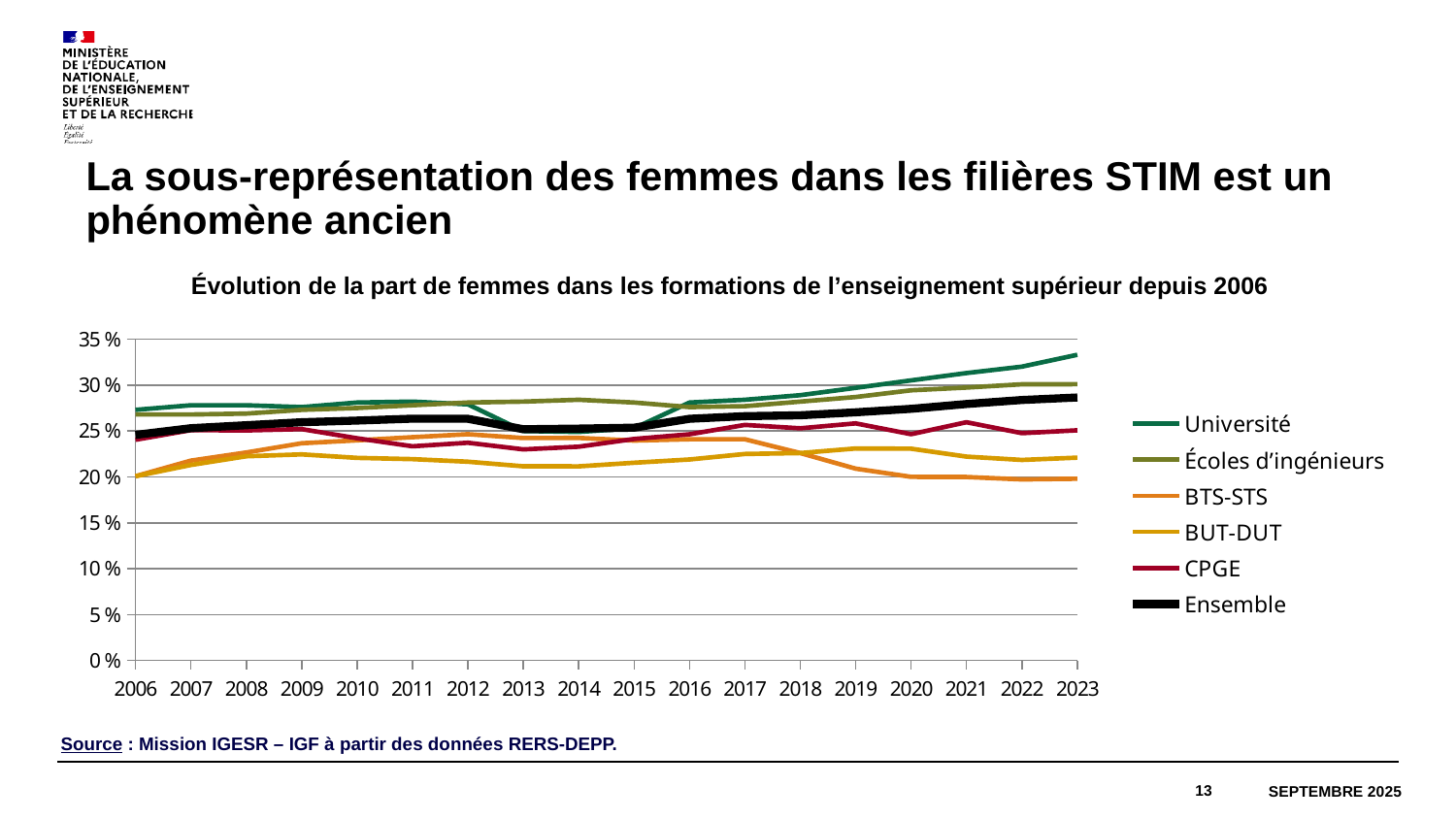
Is the value for Université in 2023 greater or less than 30 %? greater Does the Université series rise or fall between 2015 and 2023? rise How many series does the legend list? 6 Which series has the highest value in 2023? Université Is the value for Ensemble in 2023 greater or less than 25 %? greater What kind of chart is shown on the slide? line chart Does the BTS-STS series rise or fall between 2017 and 2023? fall In 2023, which is larger: the value for Ensemble or the value for CPGE? Ensemble Which series has the lowest value in 2023? BTS-STS Is the value for BUT-DUT in 2023 greater or less than 20 %? greater What is the title of the chart? Évolution de la part de femmes dans les formations de l'enseignement supérieur depuis 2006 How many years are shown along the x axis? 18